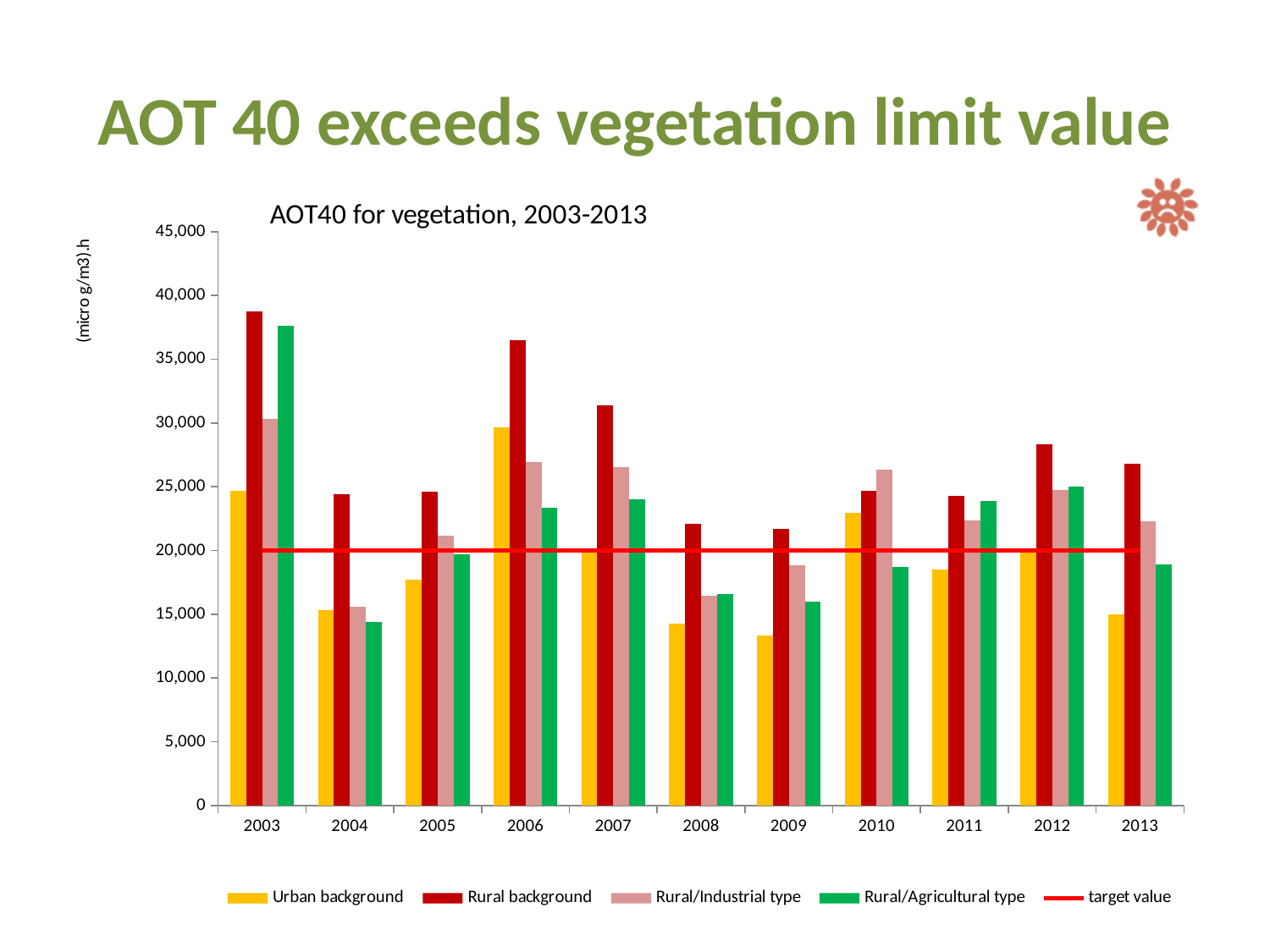
What kind of chart is shown on the slide? bar chart In which year is the Rural background value highest? 2003 What is the title of the chart? AOT40 for vegetation, 2003-2013 In 2006, which is larger: Urban background or Rural background? Rural background In 2010, which is larger: Rural/Industrial type or Rural/Agricultural type? Rural/Industrial type In which year is the Urban background value lowest? 2009 Is the Rural/Agricultural type value for 2013 greater or less than 20,000? less Is the Rural background value for 2003 greater or less than 35,000? greater How many entries does the legend list? 5 How many years are shown on the x axis? 11 In which year is the Urban background value highest? 2006 Is the Urban background value for 2009 greater or less than 15,000? less